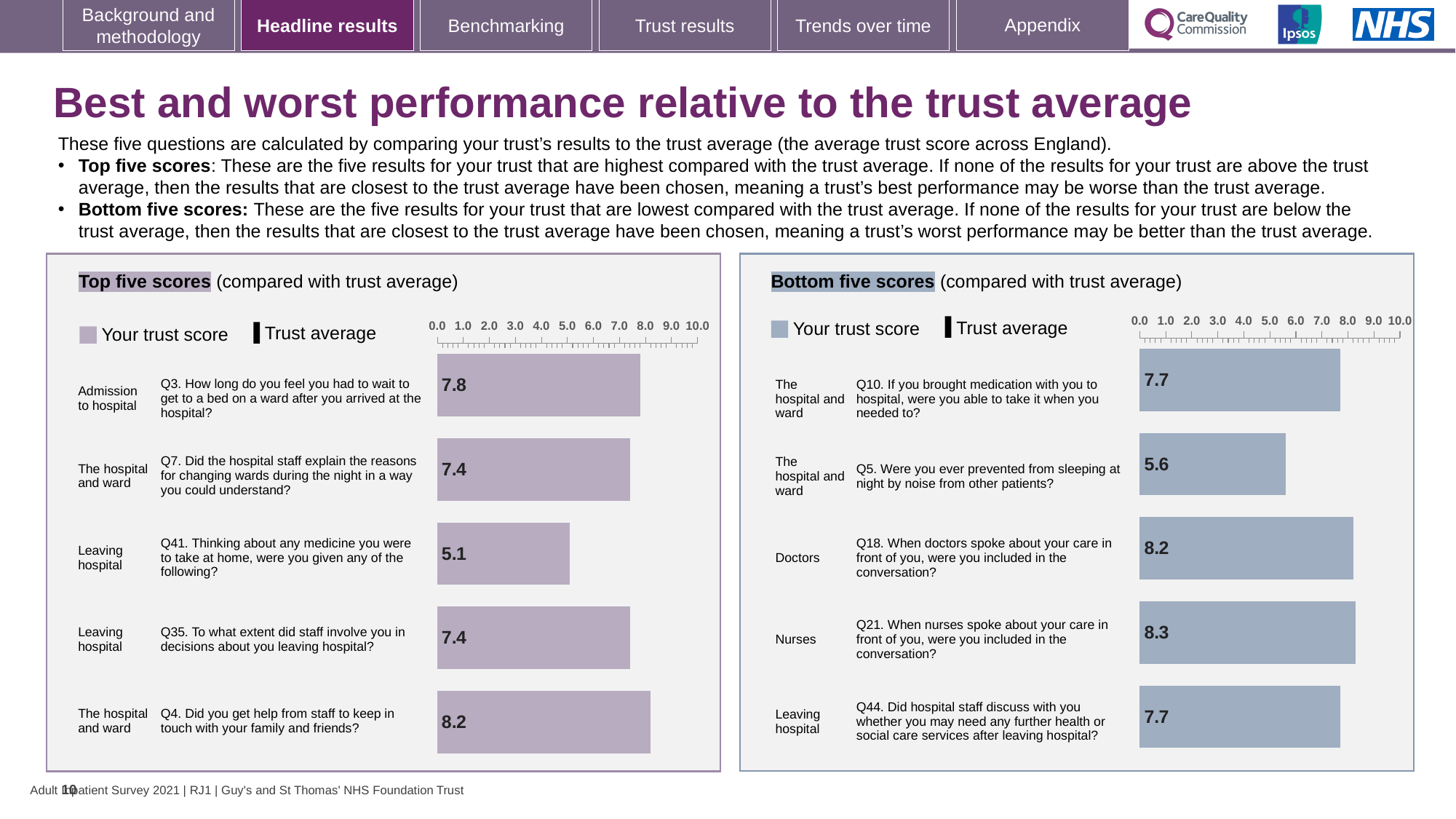
In the Top five scores chart, what is the difference between the scores for Q4 and Q41? 3.1 How many questions are plotted in the Top five scores chart? 5 How many entries does the legend of the Top five scores chart list? 2 In the Top five scores chart, which question has the lowest trust score? Q41. Thinking about any medicine you were to take at home, were you given any of the following? What type of chart is used for the Bottom five scores? Bar chart In the Bottom five scores chart, what is the trust score for Q5 (prevented from sleeping at night by noise from other patients)? 5.6 In the Bottom five scores chart, which question has the lowest trust score? Q5. Were you ever prevented from sleeping at night by noise from other patients? In the Bottom five scores chart, what is the difference between the scores for Q21 and Q10? 0.6 In the Top five scores chart, which question has the highest trust score? Q4. Did you get help from staff to keep in touch with your family and friends? In the Bottom five scores chart, which has the larger score: Q18 or Q44? Q18 In the Top five scores chart, what is the trust score for Q3 (how long you had to wait to get to a bed on a ward)? 7.8 In the Bottom five scores chart, which question has the highest trust score? Q21. When nurses spoke about your care in front of you, were you included in the conversation?